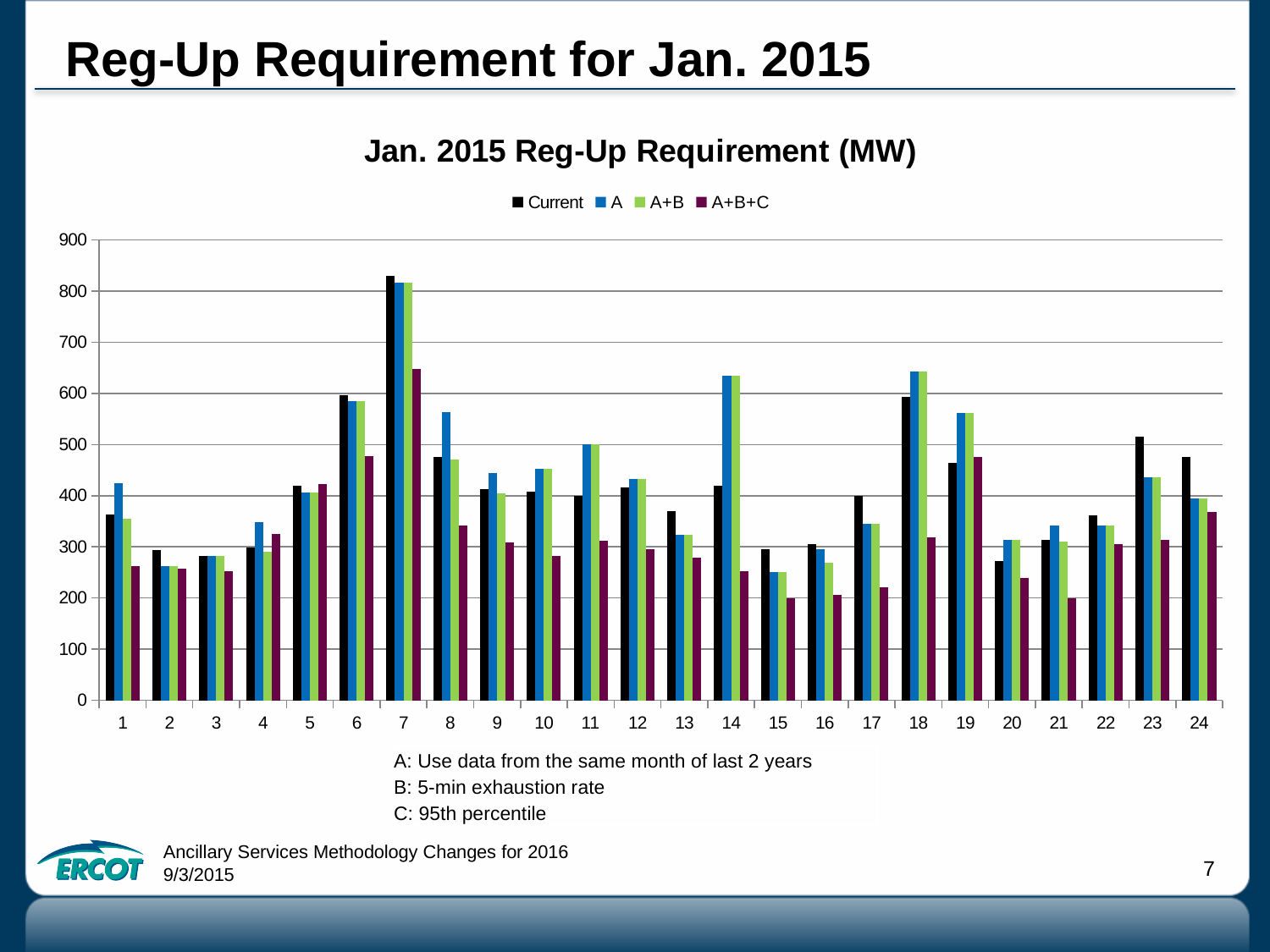
Is the Current value at hour 23 greater or less than 500? greater At hour 17, which is larger: the Current value or the A+B+C value? Current Is the A value at hour 14 greater or less than 600? greater At hour 8, which is larger: the Current value or the A value? A What kind of chart is shown on the slide? bar chart Is the A+B+C value at hour 7 greater or less than 600? greater How many hours (categories) are shown along the x axis? 24 At which hour is the Current series highest? 7 How many series does the legend list? 4 What is the title of the chart? Jan. 2015 Reg-Up Requirement (MW)